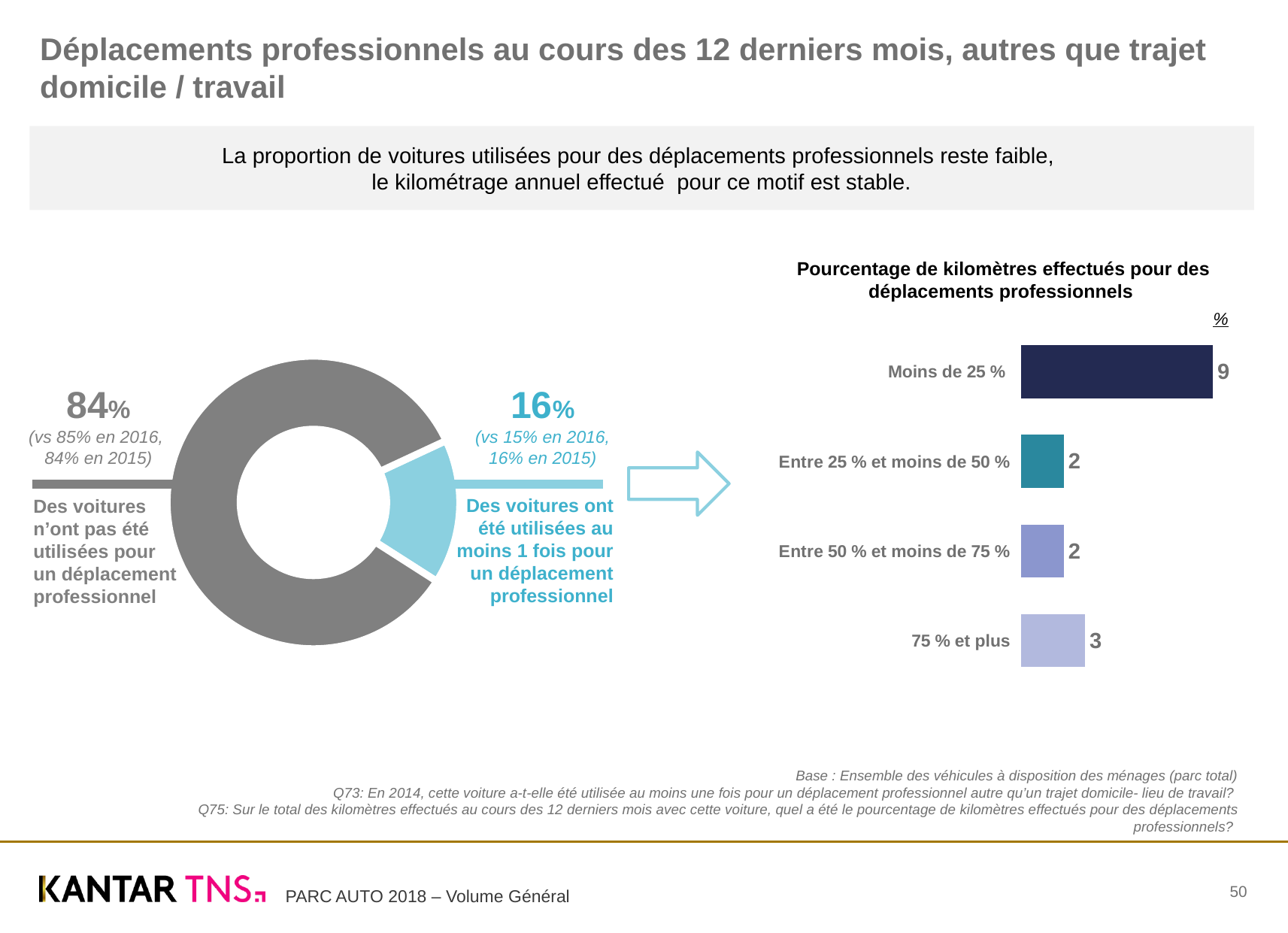
In the bar chart on the right, what is the difference between the values for 'Moins de 25 %' and '75 % et plus'? 6 In the bar chart titled 'Pourcentage de kilomètres effectués pour des déplacements professionnels', what is the value for 'Moins de 25 %'? 9 In the bar chart on the right, which category has the highest value? Moins de 25 % In the bar chart on the right, which is larger: the value for '75 % et plus' or the value for 'Entre 50 % et moins de 75 %'? 75 % et plus In the bar chart on the right, what is the value for '75 % et plus'? 3 What is the title of the bar chart on the right? Pourcentage de kilomètres effectués pour des déplacements professionnels In the donut chart on the left, what share of cars were not used for a professional trip ('Des voitures n'ont pas été utilisées pour un déplacement professionnel')? 84% What kind of chart is shown on the left side of the slide? Donut chart What kind of chart is shown on the right side of the slide? Bar chart How many categories does the bar chart on the right show? 4 In the bar chart on the right, what is the value for 'Entre 25 % et moins de 50 %'? 2 In the donut chart on the left, what share of cars were used at least once for a professional trip ('Des voitures ont été utilisées au moins 1 fois pour un déplacement professionnel')? 16%